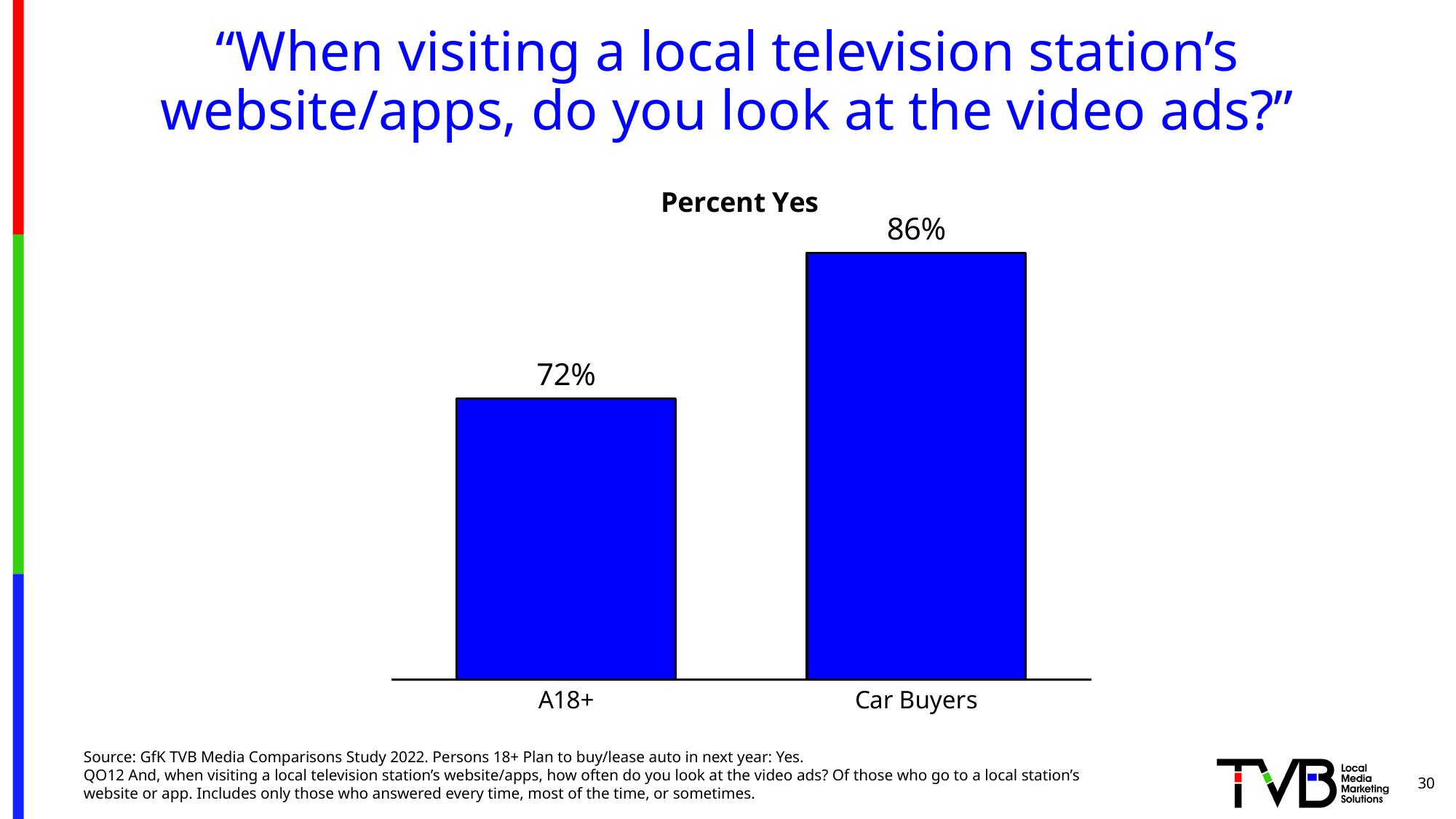
Which category has the lowest Percent Yes value? A18+ What is the Percent Yes value for Car Buyers? 86% Which category has the highest Percent Yes value? Car Buyers What is the Percent Yes value for A18+? 72% What is the difference in Percent Yes between Car Buyers and A18+? 14% How many categories are shown in the chart? 2 Which is larger, the Percent Yes for A18+ or for Car Buyers? Car Buyers What colour are the bars in the chart? Blue What kind of chart is shown on the slide? Bar chart What is the title of the chart? Percent Yes